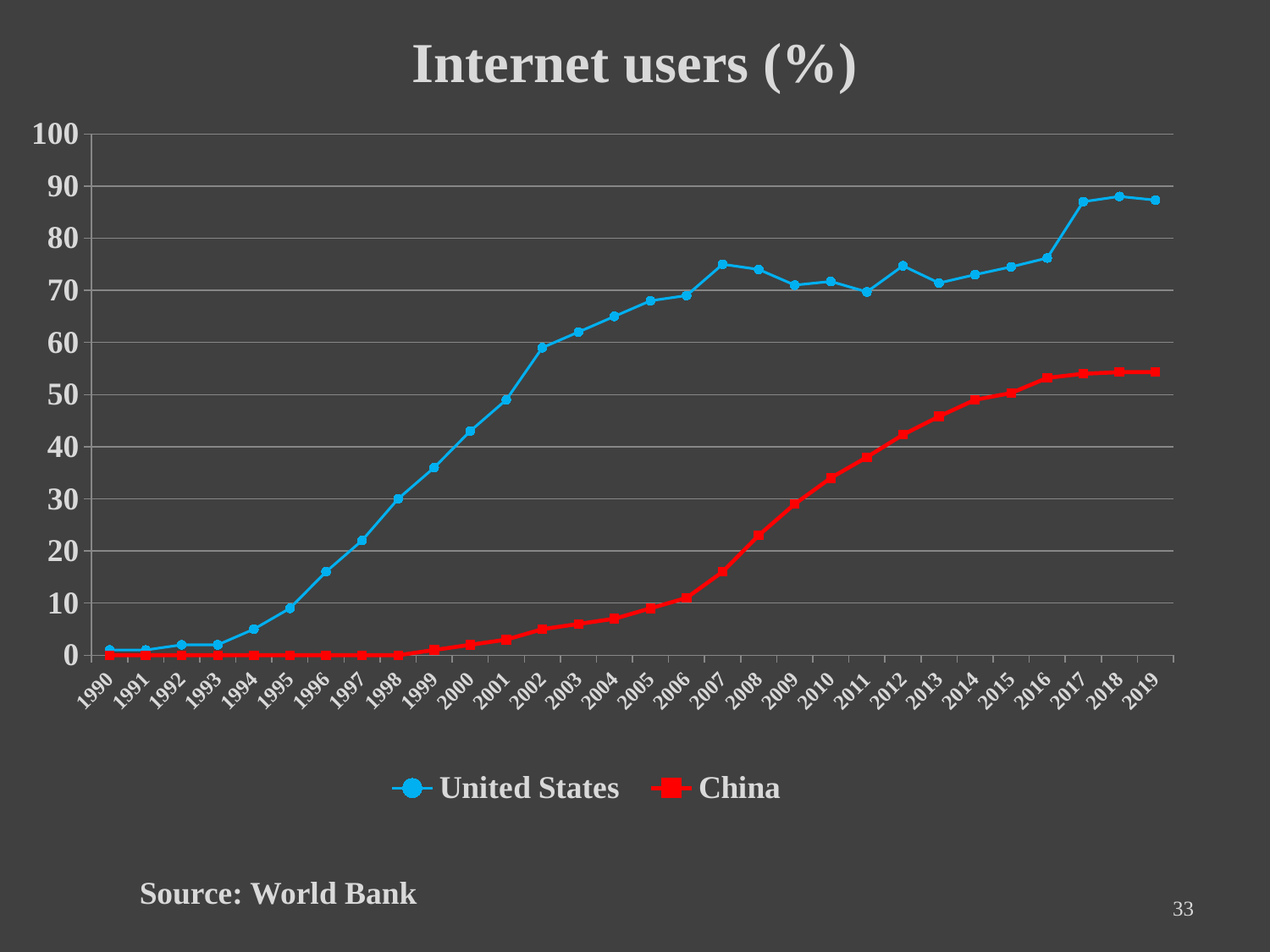
Which series has the larger value in 2010, United States or China? United States Is the value for United States in 2007 greater or less than 70? greater Does the China series rise or fall from 1990 to 2019? rise Which colour represents China in the chart? red Is the value for United States in 2000 greater or less than 40? greater How many series does the legend list? 2 How many years are plotted along the x axis? 30 Is the value for China in 2012 greater or less than 40? greater What kind of chart is shown on the slide? line chart What is the title of the chart? Internet users (%)